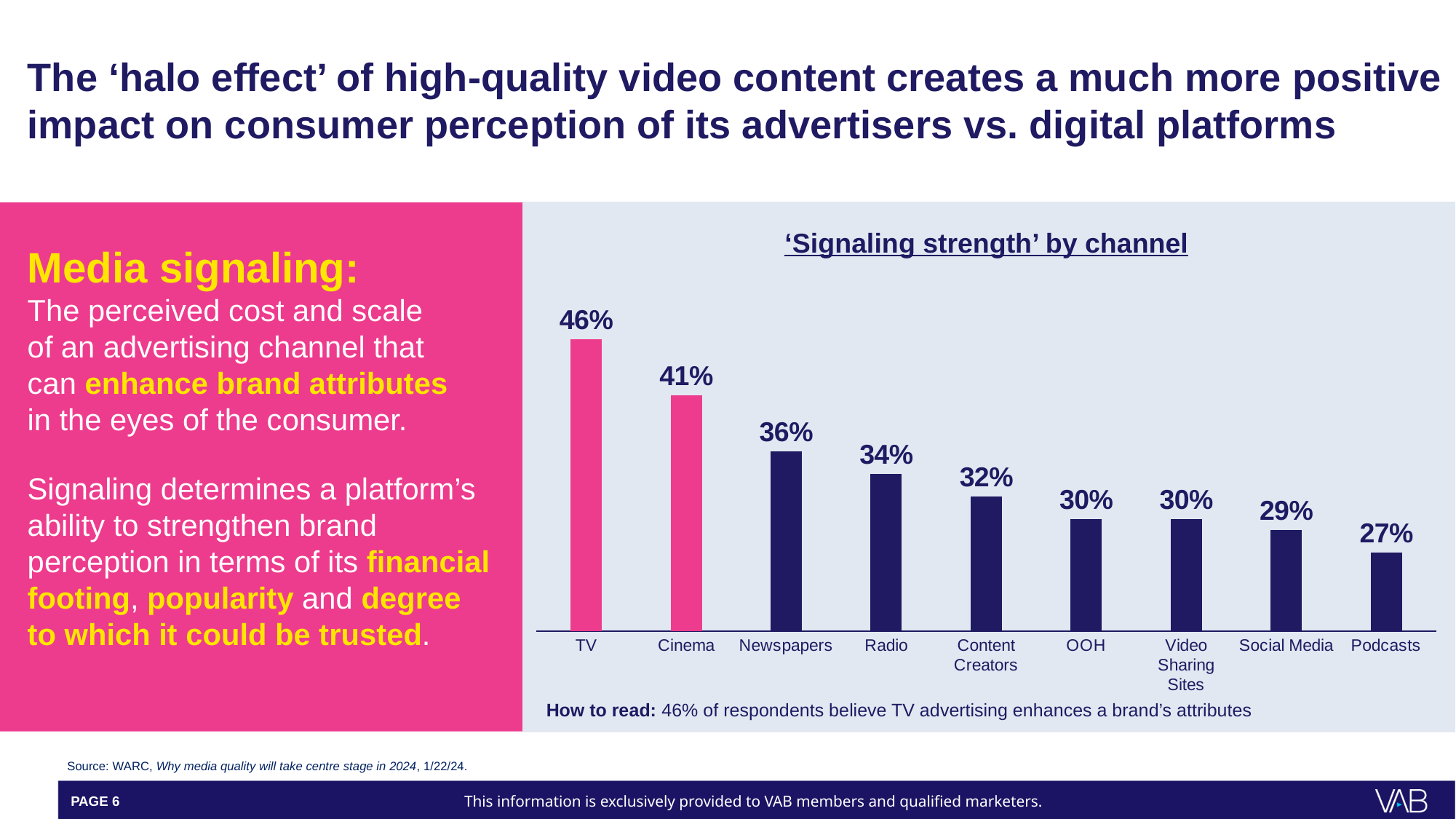
What is the difference between the values for Radio and Podcasts? 7% What is the title of the chart? 'Signaling strength' by channel Which has a higher value, Cinema or Social Media? Cinema Do the values rise or fall moving from left to right across the chart? Fall What type of chart is shown on the slide? Bar chart What is the difference between the values for TV and Cinema? 5% What is the signaling strength value for Newspapers? 36% What is the signaling strength value for TV? 46% Which channel has the lowest signaling strength? Podcasts Which channel has the highest signaling strength? TV How many channels are shown in the chart? 9 What is the signaling strength value for Content Creators? 32%